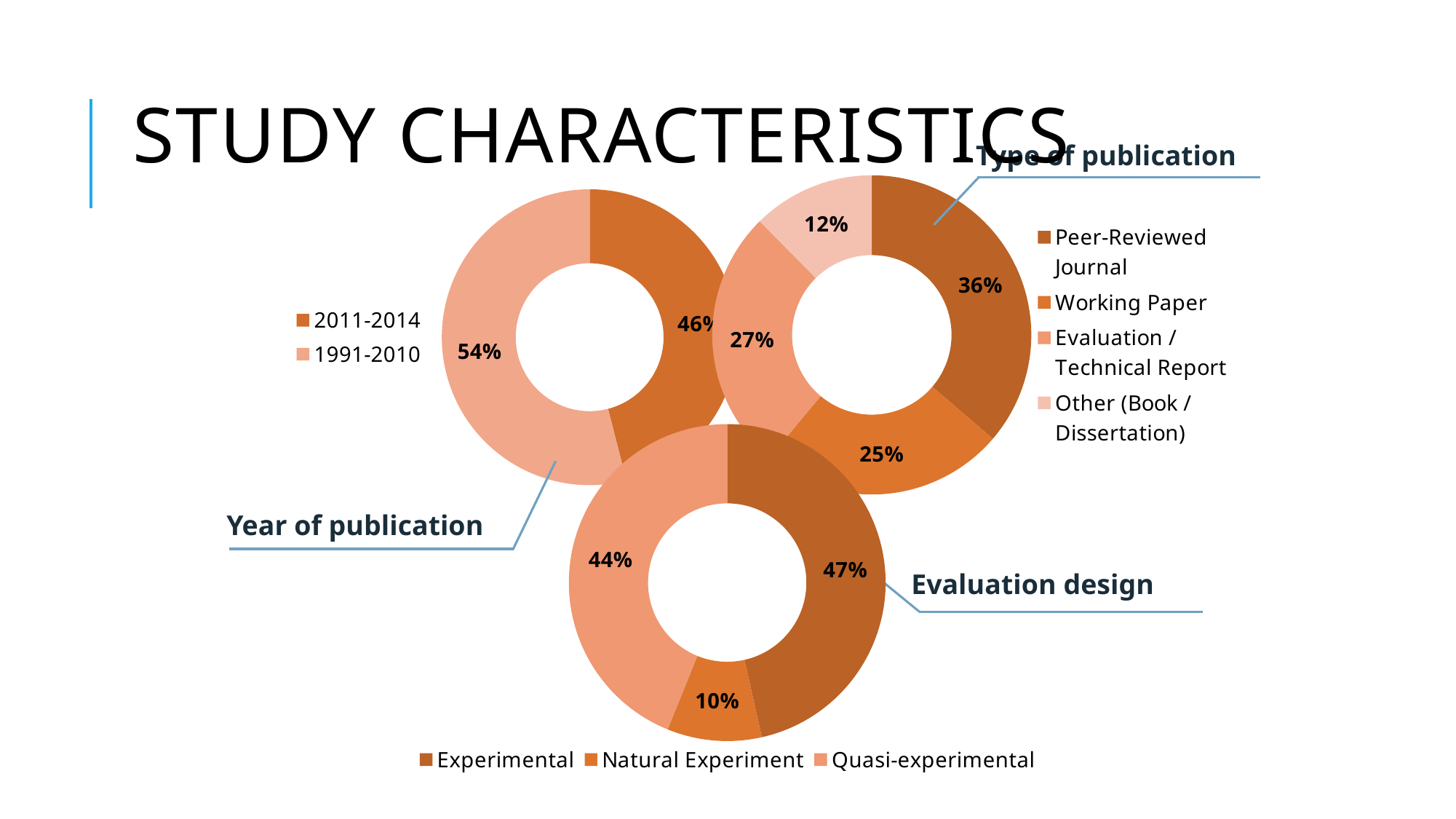
In the Type of publication chart, which category has the smallest share? Other (Book / Dissertation) In the Evaluation design chart, what is the difference in percentage points between Experimental and Natural Experiment? 37 In the Evaluation design chart, how many categories does the legend list? 3 In the Type of publication chart, what is the difference in percentage points between Peer-Reviewed Journal and Other (Book / Dissertation)? 24 In the Evaluation design chart, what percentage of studies are Quasi-experimental? 44% In the Year of publication chart, what share of studies were published in 2011-2014? 46% What type of chart is used for the Year of publication data? Doughnut chart In the Type of publication chart, what percentage are Peer-Reviewed Journal? 36% In the Year of publication chart, what share of studies were published in 1991-2010? 54% In the Evaluation design chart, which design has the largest share? Experimental In the Type of publication chart, how many categories are shown? 4 In the Type of publication chart, what percentage are Working Paper? 25%